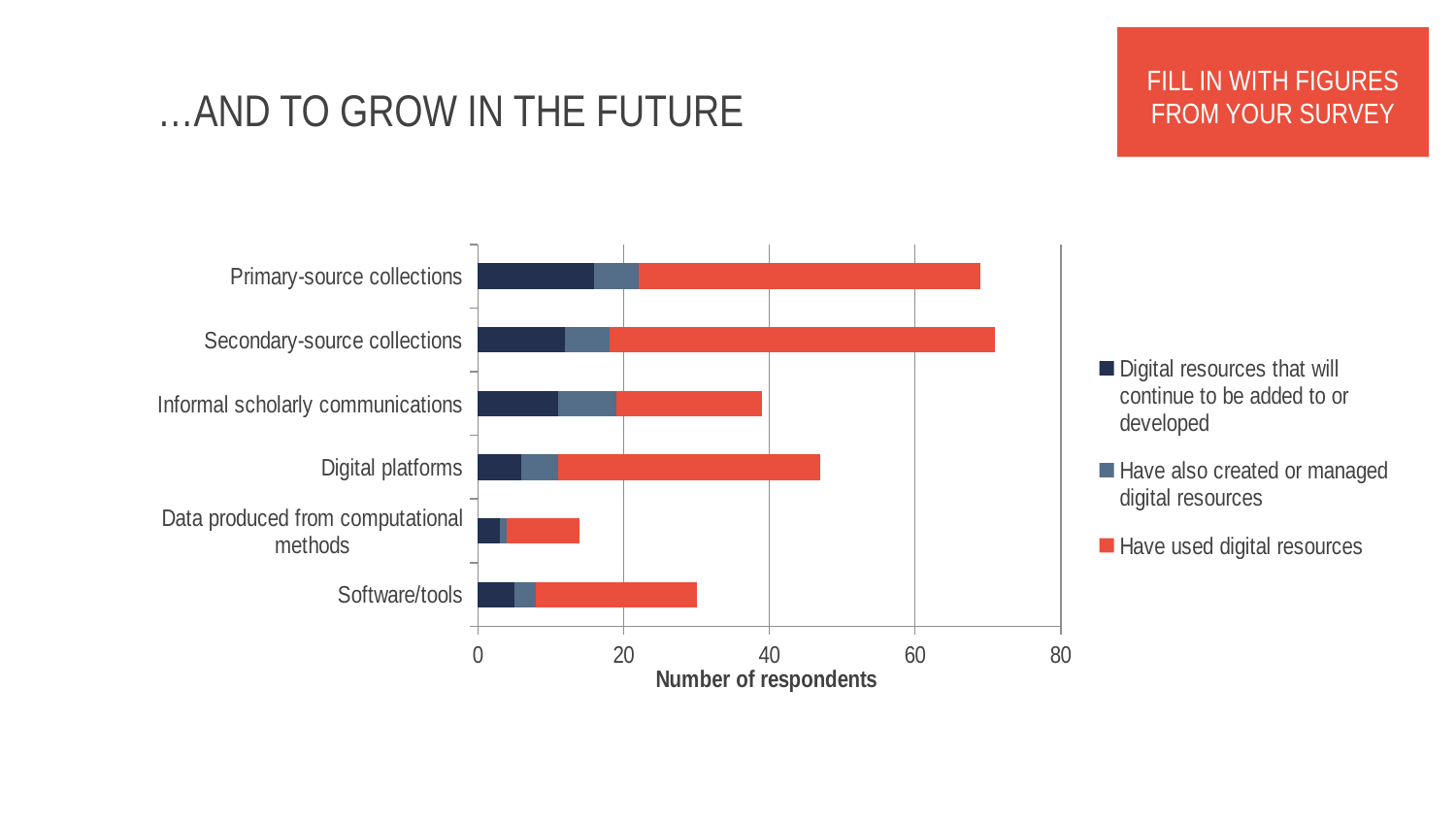
Is the total bar for Data produced from computational methods greater or less than 20? less How many categories are plotted on the chart? 6 Which has the longer total bar, Digital platforms or Informal scholarly communications? Digital platforms Which series is shown in red in the legend? Have used digital resources Is the total bar for Software/tools greater or less than 20? greater Which has the longer total bar, Software/tools or Data produced from computational methods? Software/tools How many series does the legend list? 3 What kind of chart is shown on the slide? Stacked bar chart What is the title of the horizontal axis? Number of respondents Is the total bar for Digital platforms greater or less than 40? greater Which category has the shortest total bar? Data produced from computational methods